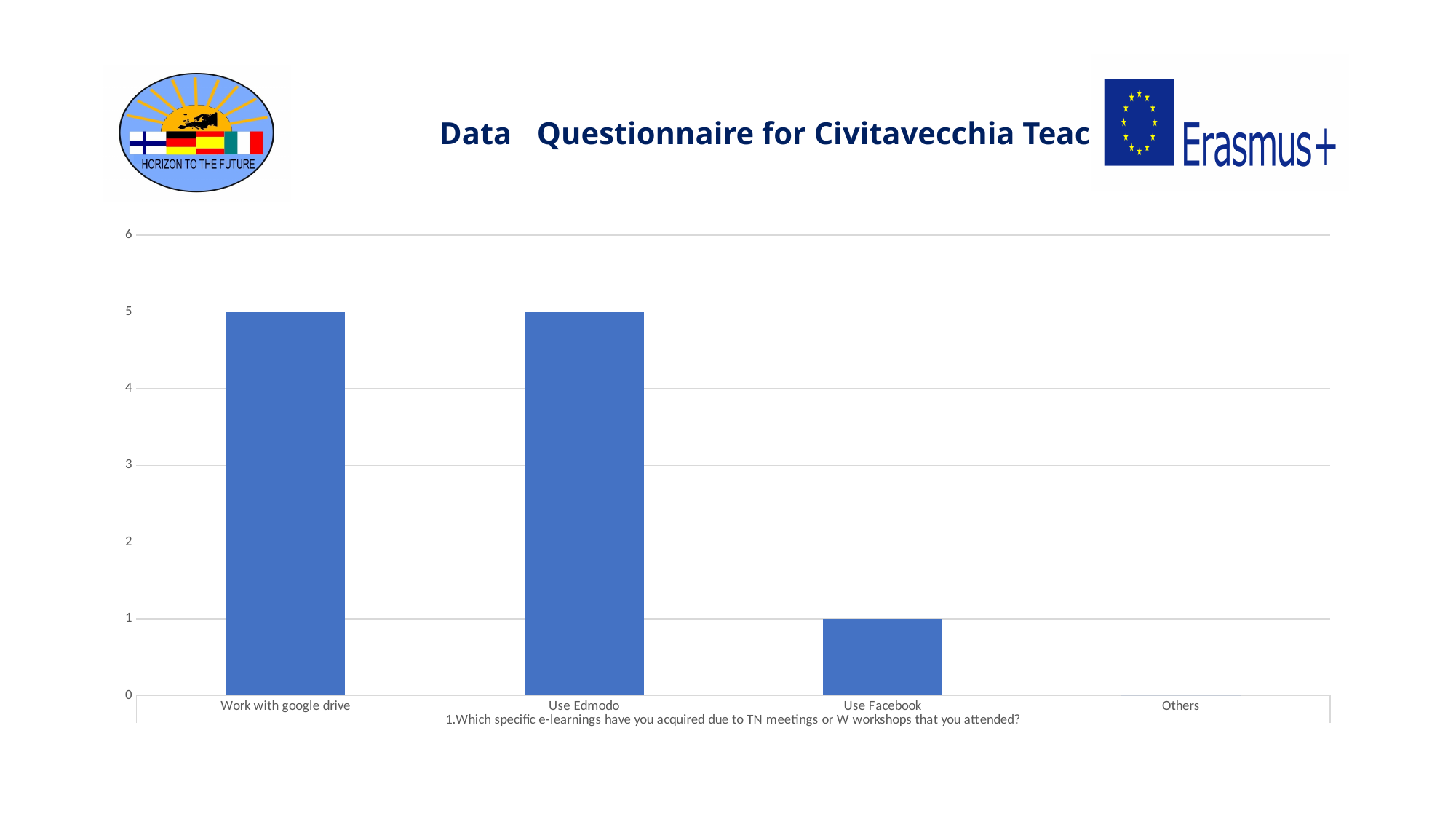
Is the value for "Use Facebook" greater or less than 3? less Which category has the lowest value? Others What is the difference between the value for "Work with google drive" and the value for "Use Facebook"? 4 What is the value for "Use Edmodo"? 5 What is the highest value shown on the vertical axis? 6 What type of chart is shown on the slide? bar chart How many categories are shown on the x axis of the chart? 4 Which is larger, the value for "Use Edmodo" or the value for "Use Facebook"? Use Edmodo What is the value for "Others"? 0 What is the value for "Work with google drive"? 5 What is the value for "Use Facebook"? 1 What is the x-axis title of the chart? 1.Which specific e-learnings have you acquired due to TN meetings or W workshops that you attended?